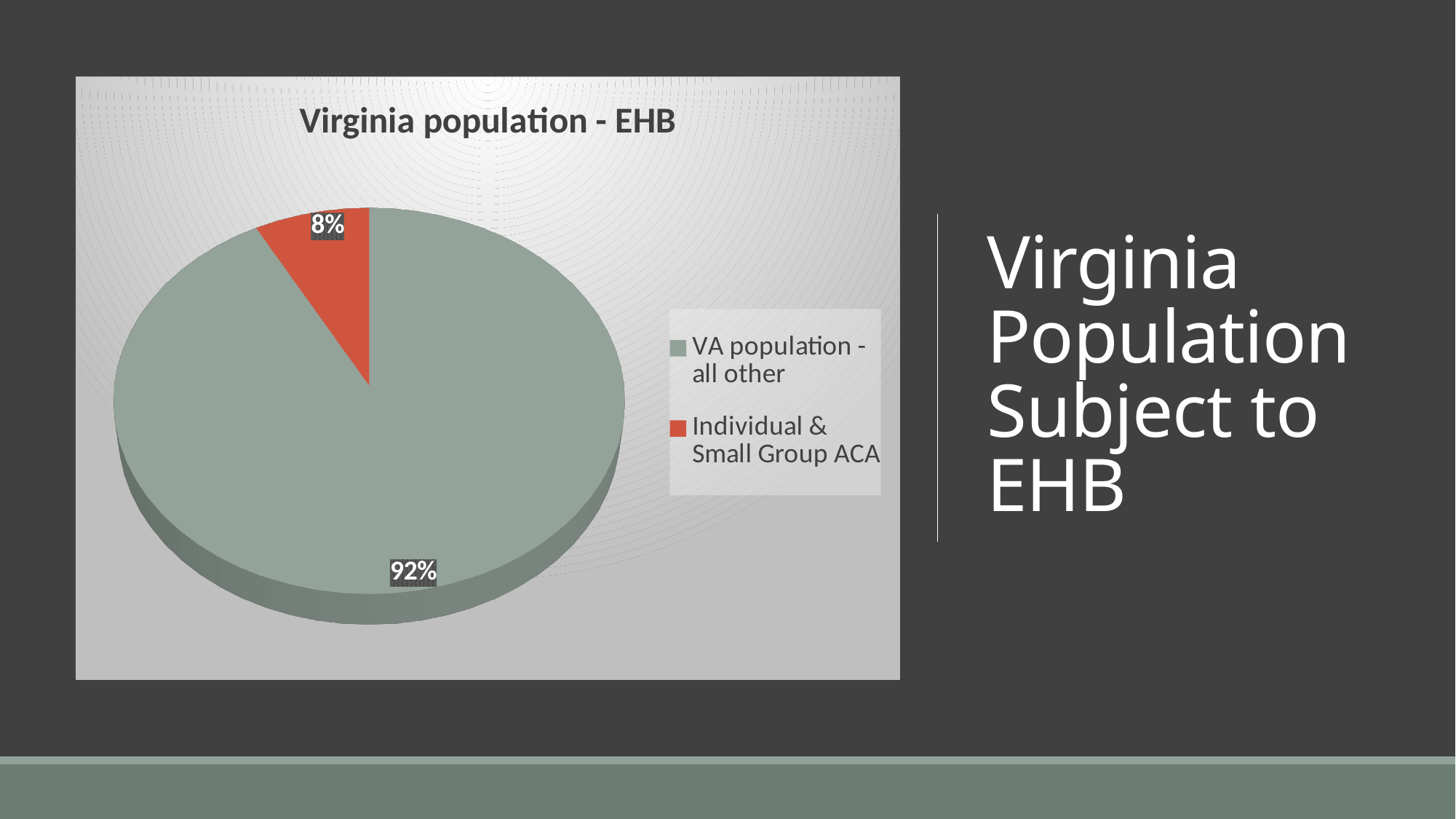
Which is larger: 'VA population - all other' or 'Individual & Small Group ACA'? VA population - all other Which slice is the largest? VA population - all other How many entries does the legend list? 2 Which slice is the smallest? Individual & Small Group ACA What percentage of the pie is 'VA population - all other'? 92% How many slices does the pie chart have? 2 What percentage of the pie is 'Individual & Small Group ACA'? 8% What share of the pie does 'Individual & Small Group ACA' represent? 8% What type of chart is shown on the slide? Pie chart What is the difference in percentage points between the 'VA population - all other' slice and the 'Individual & Small Group ACA' slice? 84 What is the title of the chart? Virginia population - EHB What colour is the 'Individual & Small Group ACA' slice? Red/orange